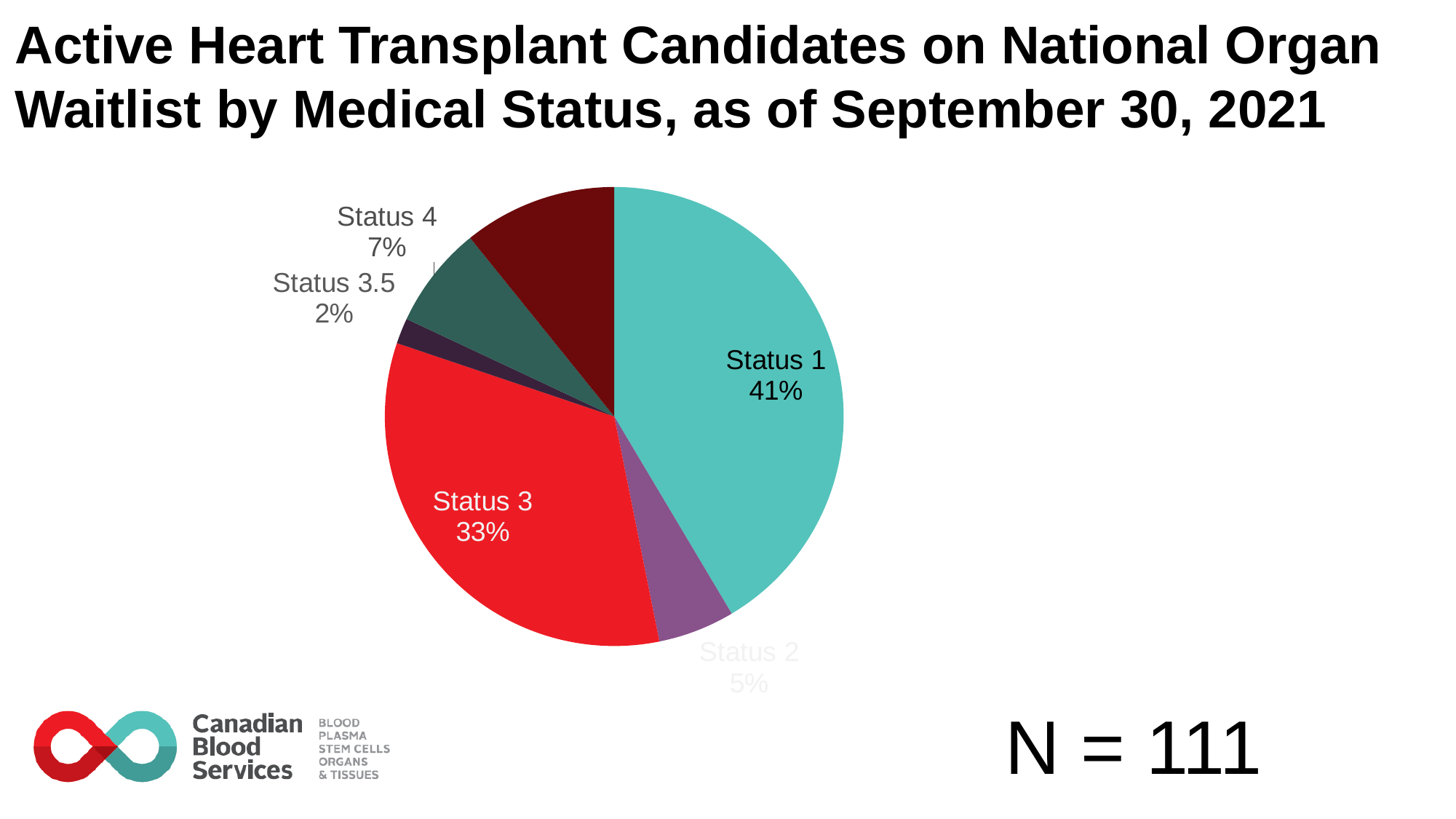
What kind of chart is shown on the slide? Pie chart Which has the larger share, Status 4 or Status 2? Status 4 How many percentage points larger is the Status 1 share than the Status 3 share? 8 percentage points What share of active heart transplant candidates are Status 1? 41% Which labelled medical status has the smallest share of the pie? Status 3.5 What share of the pie is Status 2? 5% What percentage is labelled for Status 3.5? 2% What share is shown for Status 4? 7% What is the total number of candidates (N) stated on the slide? N = 111 What percentage of the pie is Status 3? 33% Which medical status has the largest share of the pie? Status 1 How many slices does the pie chart have? 6